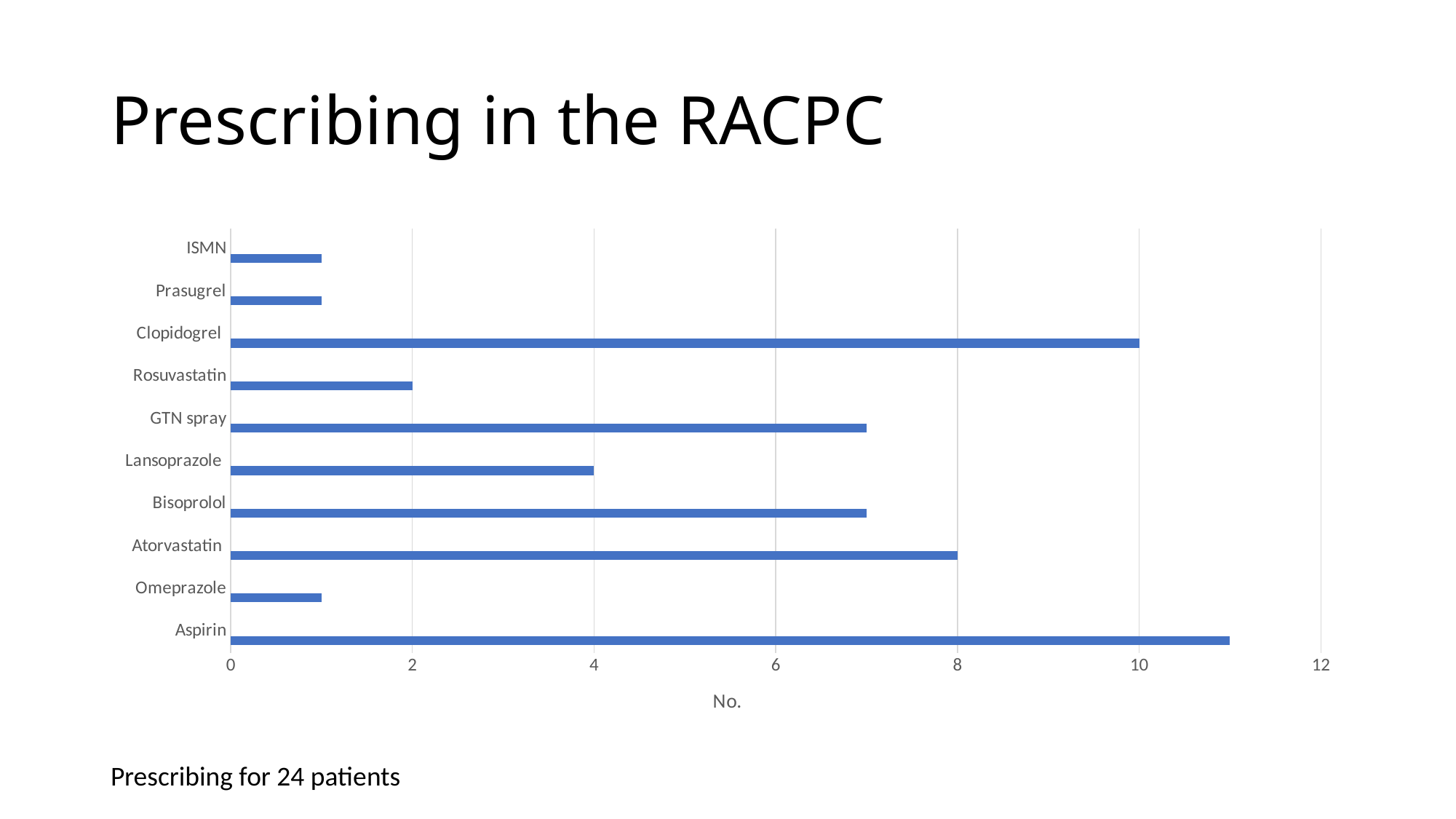
Is the value for ISMN greater or less than 2? less Which drug has the highest value in the chart? Aspirin Is the value for GTN spray greater or less than 6? greater What is the difference between the values for Clopidogrel and Rosuvastatin? 8 How many drugs (categories) are plotted in the chart? 10 What type of chart is shown on the slide? bar chart What is the value for Clopidogrel? 10 Is the value for Aspirin greater or less than 10? greater What is the label on the horizontal axis of the chart? No. What is the value for Lansoprazole? 4 What is the value for Atorvastatin? 8 What is the value for Rosuvastatin? 2